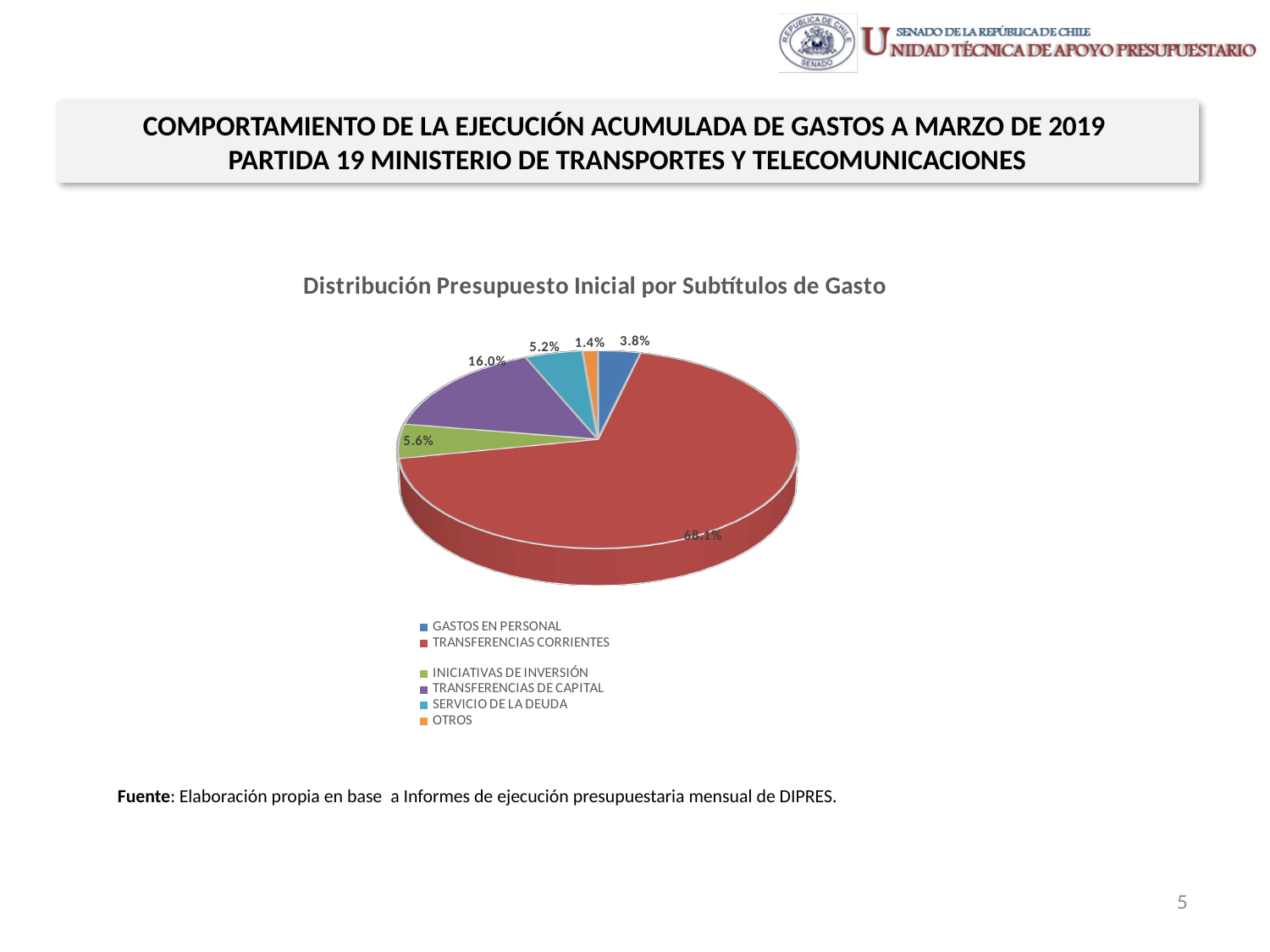
What share of the pie does TRANSFERENCIAS CORRIENTES represent? 68.1% How many categories does the legend list? 6 Which category has the smallest slice of the pie? OTROS What share of the pie does SERVICIO DE LA DEUDA represent? 5.2% What share of the pie does INICIATIVAS DE INVERSIÓN represent? 5.6% What is the difference in percentage points between TRANSFERENCIAS DE CAPITAL and INICIATIVAS DE INVERSIÓN? 10.4 percentage points Which category has the largest slice of the pie? TRANSFERENCIAS CORRIENTES What is the title of the chart? Distribución Presupuesto Inicial por Subtítulos de Gasto What type of chart is shown on the slide? Pie chart